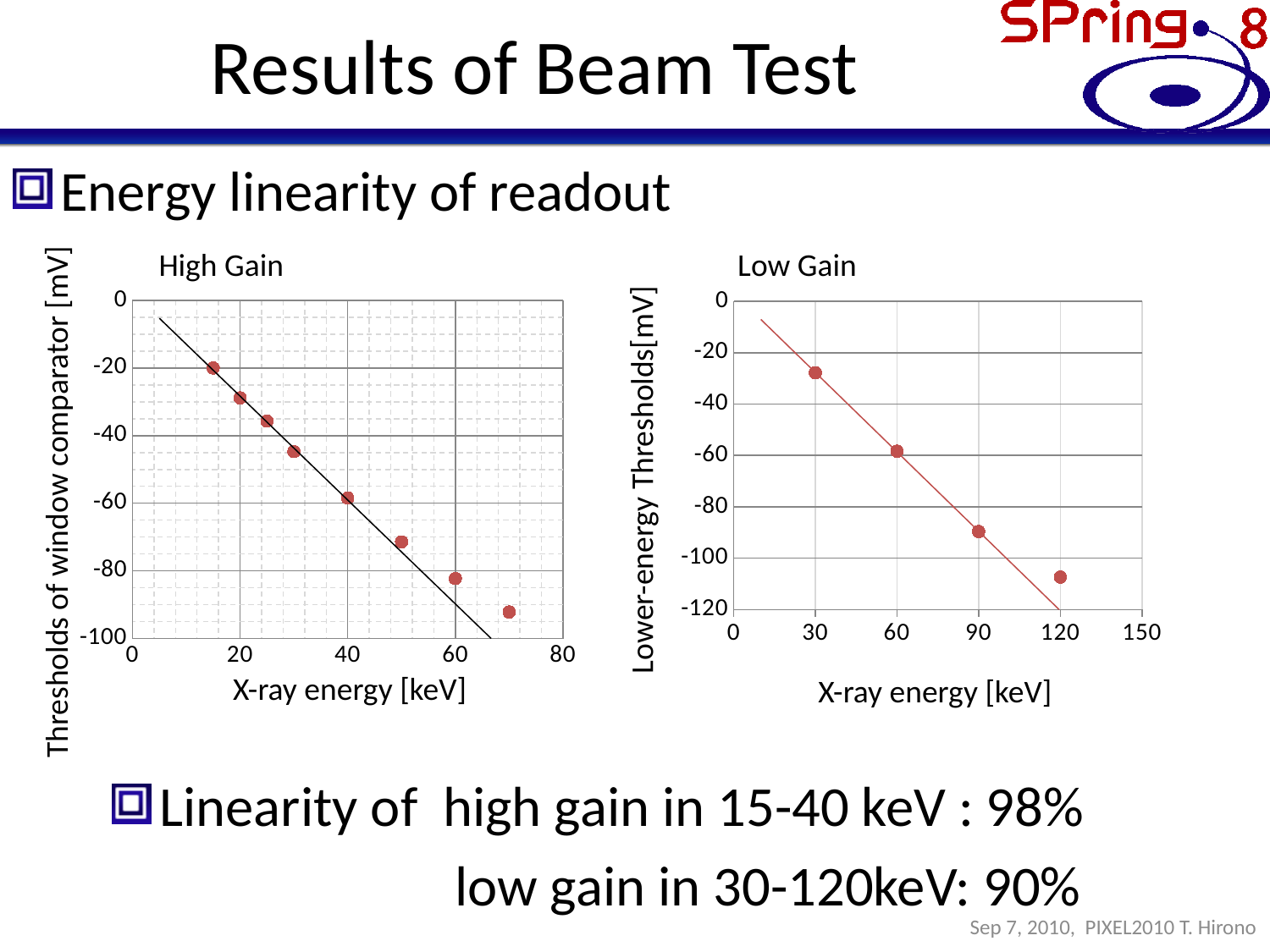
In the High Gain chart, do the threshold values rise or fall as X-ray energy increases? fall How many data points are plotted in the Low Gain chart? 4 What kind of chart is the High Gain chart? scatter chart In the Low Gain chart, do the threshold values rise or fall as X-ray energy increases? fall In the High Gain chart, is the value at 50 keV greater or less than -60? less How many data points are plotted in the High Gain chart? 8 In the Low Gain chart, is the value at 30 keV greater or less than -40? greater What kind of chart is the Low Gain chart? scatter chart What is the y-axis title of the High Gain chart? Thresholds of window comparator [mV] In the High Gain chart, is the value at 70 keV greater or less than -80? less What is the x-axis title of the Low Gain chart? X-ray energy [keV]